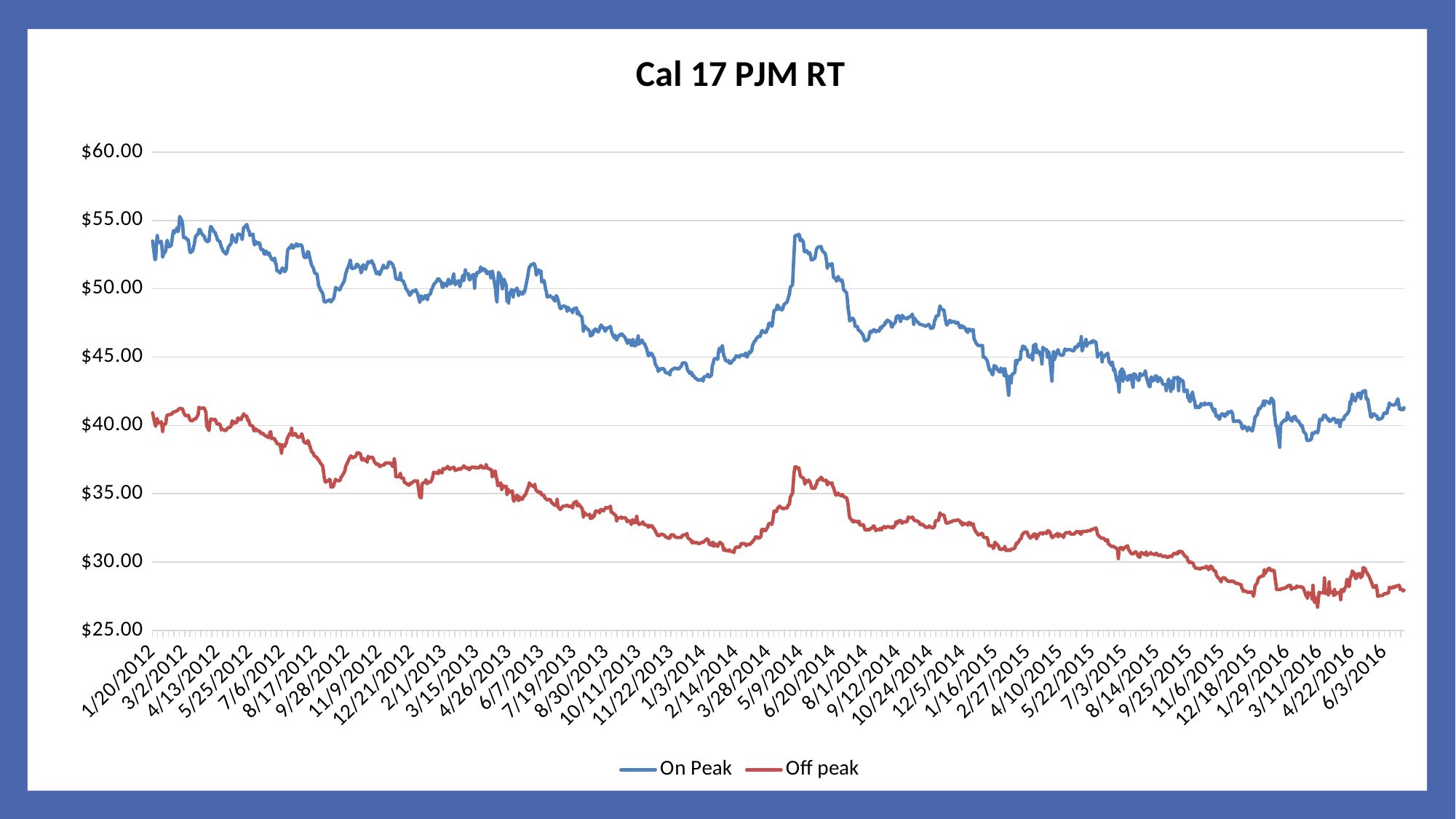
Does the Off peak series generally rise or fall across the x axis? Fall Is the Off peak value at 1/20/2012 greater or less than $35.00? greater Which series is higher throughout the chart, On Peak or Off peak? On Peak Is the On Peak value at 6/3/2016 greater or less than $45.00? less Is the On Peak value at 1/20/2012 greater or less than $50.00? greater Which colour is used for the Off peak series? Red Does the On Peak series generally rise or fall from 1/20/2012 to 6/3/2016? Fall How many series does the legend list? 2 What is the title of the chart? Cal 17 PJM RT What kind of chart is shown on the slide? Line chart